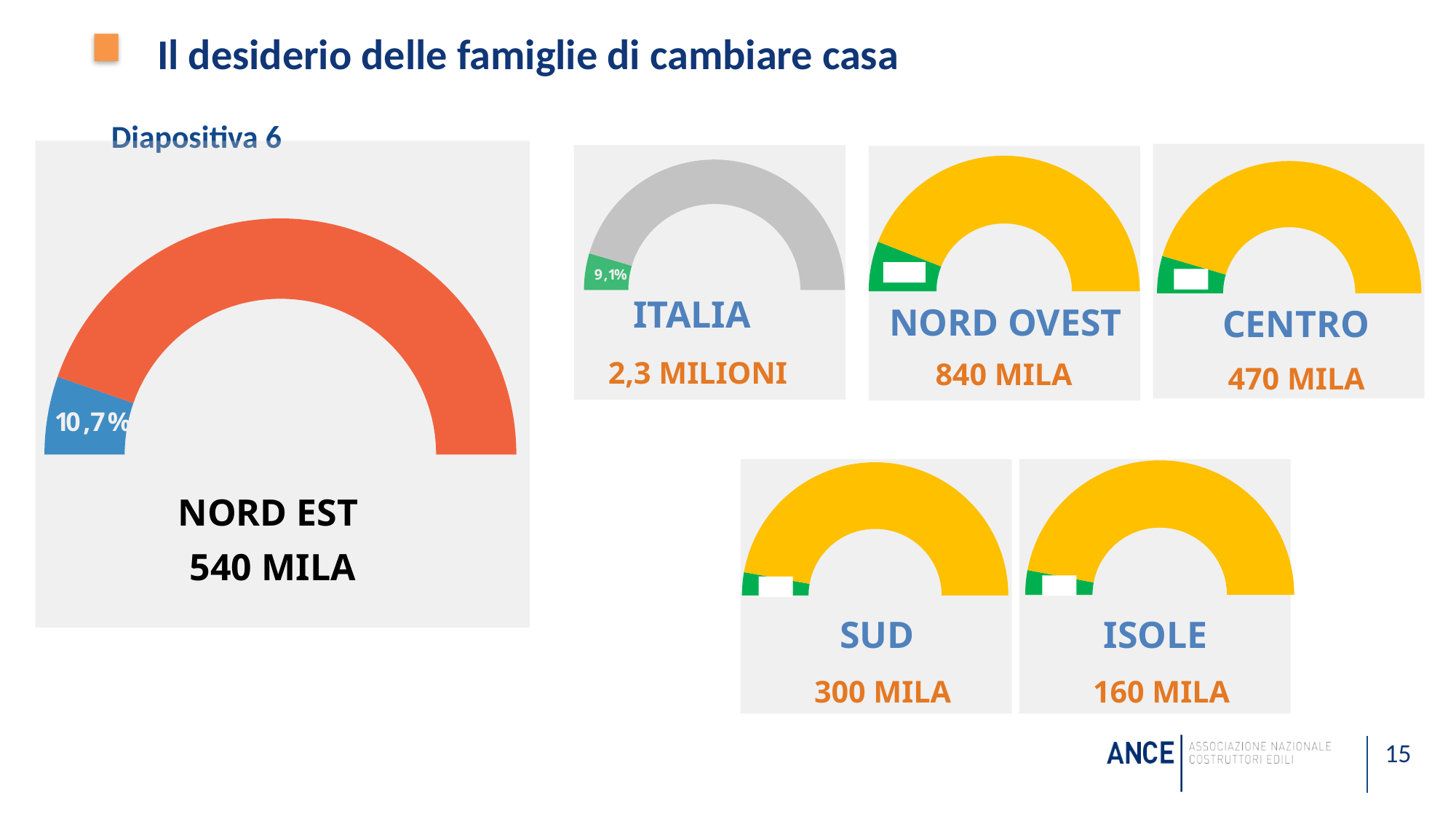
How many gauge charts are shown on the slide? 6 What number of families is shown under the ISOLE chart? 160 MILA What number of families is shown under the CENTRO chart? 470 MILA What number of families is shown under the NORD OVEST chart? 840 MILA What is the difference between the NORD OVEST value and the NORD EST value? 300 MILA Among the regional charts (NORD EST, NORD OVEST, CENTRO, SUD, ISOLE), which region has the lowest number of families? ISOLE What percentage is shown on the ITALIA chart? 9,1% Which percentage is larger, the one on the NORD EST chart or the one on the ITALIA chart? NORD EST (10,7%) What total is shown under the ITALIA chart? 2,3 MILIONI What kind of chart is used for each region on the slide? Semi-circular doughnut (gauge) chart What percentage is shown on the NORD EST chart? 10,7% Among the regional charts (NORD EST, NORD OVEST, CENTRO, SUD, ISOLE), which region has the highest number of families? NORD OVEST